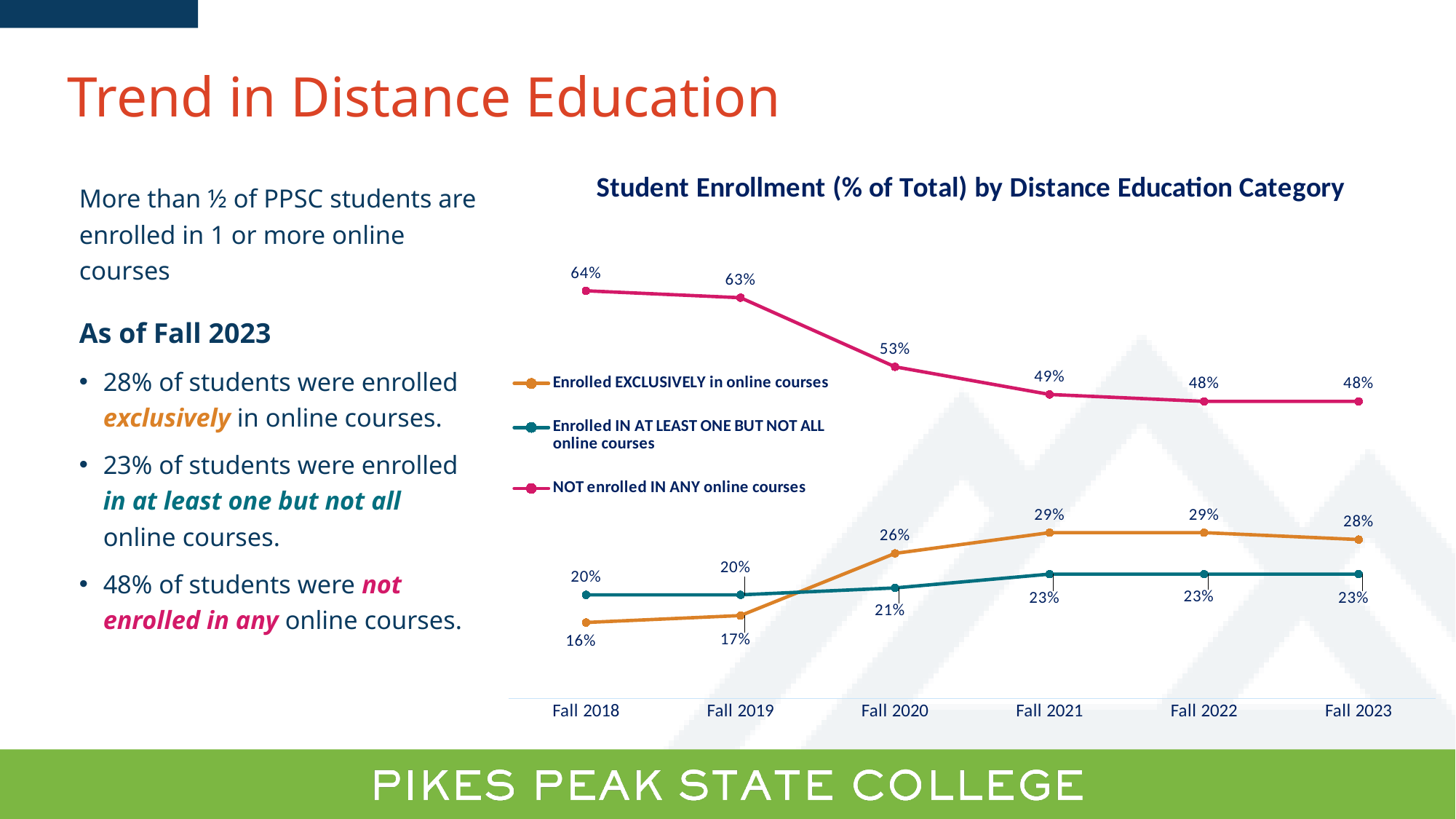
What percentage of students were Enrolled EXCLUSIVELY in online courses in Fall 2020? 26% In Fall 2019, which was larger: Enrolled EXCLUSIVELY in online courses or Enrolled IN AT LEAST ONE BUT NOT ALL online courses? Enrolled IN AT LEAST ONE BUT NOT ALL online courses What percentage of students were NOT enrolled IN ANY online courses in Fall 2018? 64% What is the difference between the NOT enrolled IN ANY online courses value in Fall 2018 and in Fall 2023? 16% Does the NOT enrolled IN ANY online courses series rise or fall from Fall 2018 to Fall 2023? Fall What percentage of students were Enrolled IN AT LEAST ONE BUT NOT ALL online courses in Fall 2023? 23% What type of chart is shown on the slide? Line chart What is the title of the chart? Student Enrollment (% of Total) by Distance Education Category How many series does the legend list? 3 In which year was the Enrolled EXCLUSIVELY in online courses series at its lowest? Fall 2018 How many time points are plotted along the x axis? 6 In which year was the NOT enrolled IN ANY online courses series at its highest? Fall 2018